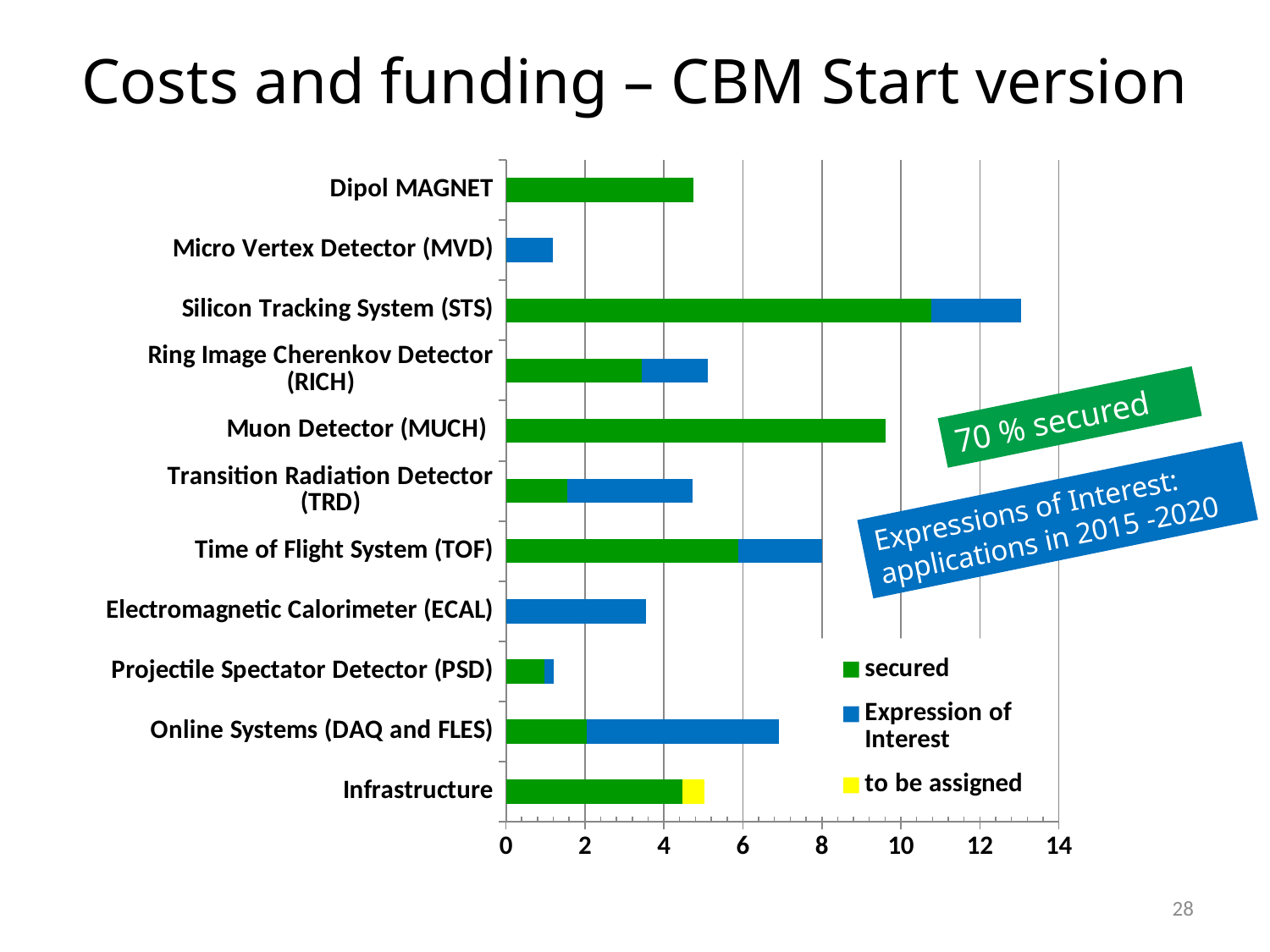
How many series does the legend list? 3 Which has the longer total bar, Muon Detector (MUCH) or Time of Flight System (TOF)? Muon Detector (MUCH) Is the total bar for Silicon Tracking System (STS) greater or less than 12? greater What colour represents the 'secured' series in the legend? Green Which category is the only one with a 'to be assigned' (yellow) segment? Infrastructure Is the value for Electromagnetic Calorimeter (ECAL) greater or less than 4? less Which category has the longest total bar? Silicon Tracking System (STS) Is the value for Muon Detector (MUCH) greater or less than 8? greater How many categories (detector systems) are listed on the chart? 11 What kind of chart is shown on the slide? Stacked bar chart